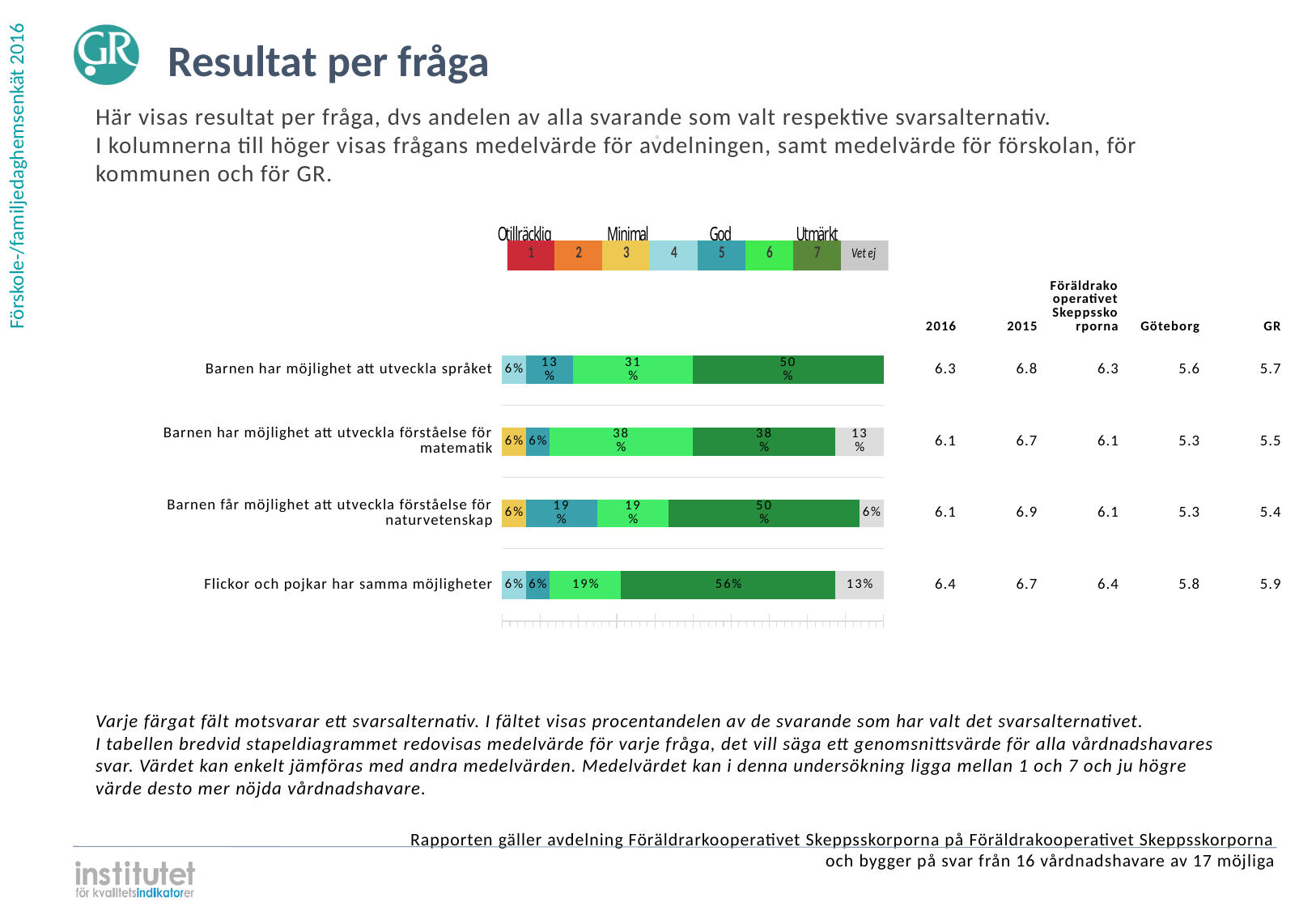
What percentage of respondents chose the dark green '7' (Utmärkt) alternative for 'Barnen har möjlighet att utveckla språket'? 50% In the table next to the chart, what is the 2016 mean value for 'Flickor och pojkar har samma möjligheter'? 6.4 Which is larger: the '7' share for 'Barnen har möjlighet att utveckla förståelse för matematik' or the '7' share for 'Barnen får möjlighet att utveckla förståelse för naturvetenskap'? Barnen får möjlighet att utveckla förståelse för naturvetenskap How many response alternatives does the legend above the chart list? 8 What label does the legend give to the grey box at the right end of the scale? Vet ej For 'Barnen har möjlighet att utveckla språket', what is the difference between the '7' share and the '6' share? 19 percentage points What percentage chose the light green '6' alternative for 'Barnen har möjlighet att utveckla förståelse för matematik'? 38% What percentage answered 'Vet ej' for 'Flickor och pojkar har samma möjligheter'? 13% Which question has the largest share of respondents choosing the dark green '7' (Utmärkt) alternative? Flickor och pojkar har samma möjligheter How many questions (categories) are plotted in the bar chart? 4 What percentage chose the teal '5' alternative for 'Barnen får möjlighet att utveckla förståelse för naturvetenskap'? 19% What kind of chart is shown on the slide? Stacked bar chart